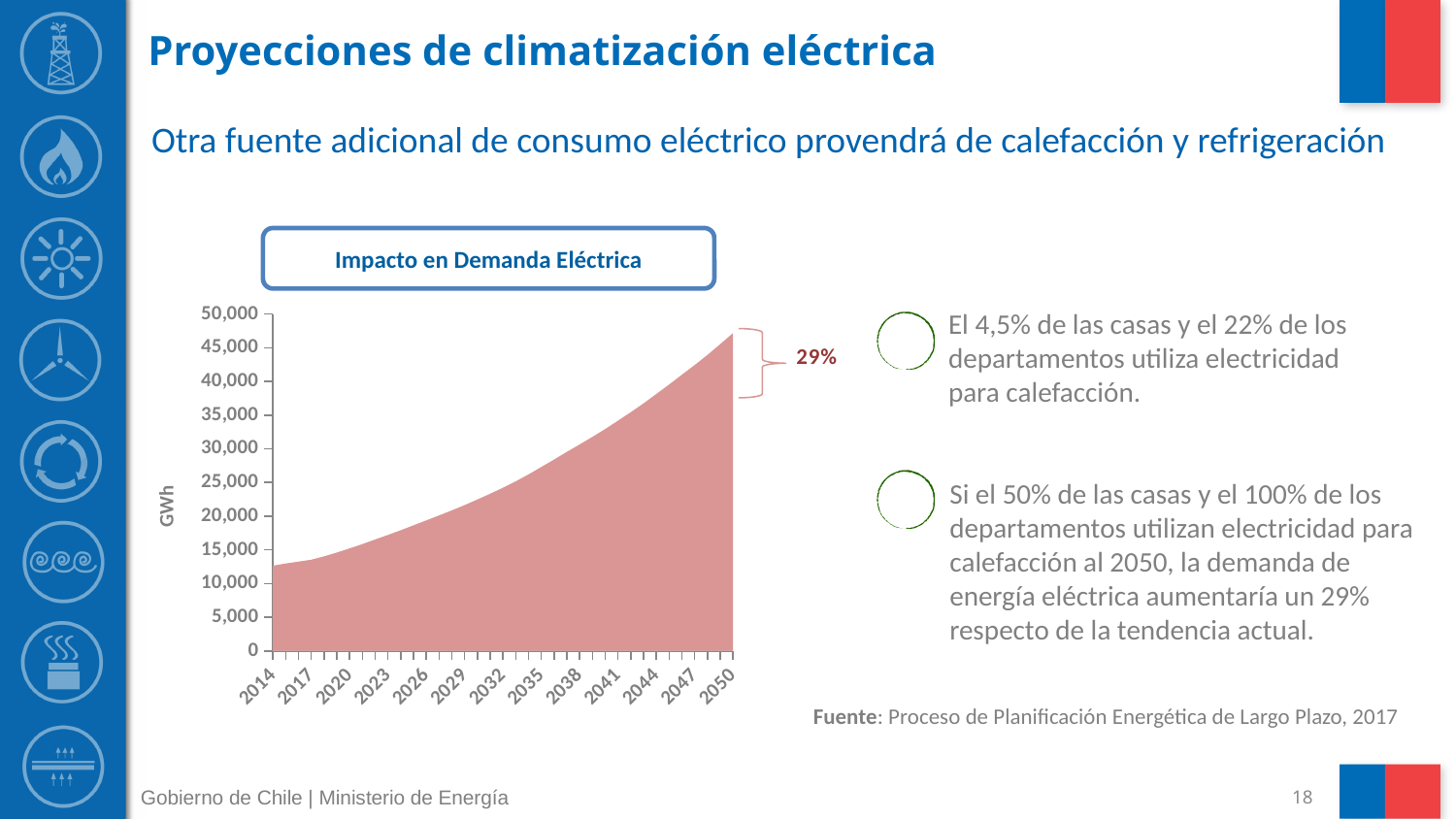
What percentage is annotated next to the bracket at the right end of the 'Impacto en Demanda Eléctrica' chart? 29% Do the values in the 'Impacto en Demanda Eléctrica' chart rise or fall from 2014 to 2050? rise In which year does the 'Impacto en Demanda Eléctrica' chart reach its highest value? 2050 In which year does the 'Impacto en Demanda Eléctrica' chart show its lowest value? 2014 Which year has the larger value in the 'Impacto en Demanda Eléctrica' chart, 2029 or 2047? 2047 How many year labels are shown on the x axis of the 'Impacto en Demanda Eléctrica' chart? 13 Is the value for 2050 in the 'Impacto en Demanda Eléctrica' chart greater or less than 45,000? greater Is the value for 2020 in the 'Impacto en Demanda Eléctrica' chart greater or less than 20,000? less Is the value for 2041 in the 'Impacto en Demanda Eléctrica' chart greater or less than 30,000? greater What unit is shown on the y axis of the 'Impacto en Demanda Eléctrica' chart? GWh What kind of chart is shown under the title 'Impacto en Demanda Eléctrica'? area chart